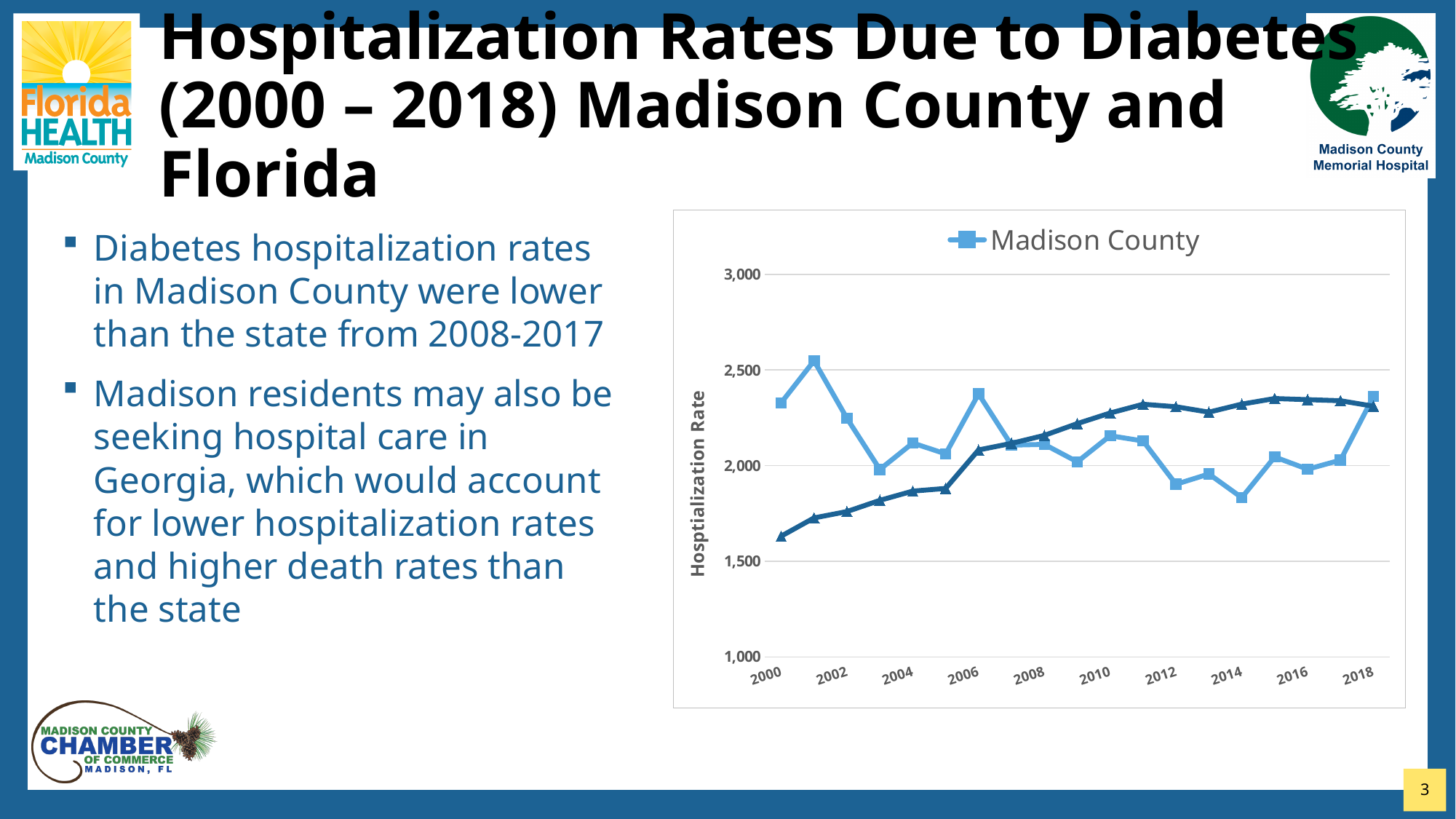
How many years are plotted for the Madison County series, from 2000 to 2018? 19 What kind of chart is shown on the slide? line chart What is the title of the vertical axis of the chart? Hosptialization Rate Which series is named in the chart legend? Madison County In which year is the Madison County hospitalization rate highest? 2001 Which is larger for Madison County: the value for 2001 or the value for 2014? 2001 In which year is the Madison County hospitalization rate lowest? 2014 Is the Madison County value for 2001 greater or less than 2,500? greater Does the dark blue line (the state series) generally rise or fall from 2000 to 2018? rise Is the Madison County value for 2012 greater or less than 2,000? less How many series does the chart legend list? 1 Is the Madison County value for 2014 greater or less than 2,000? less